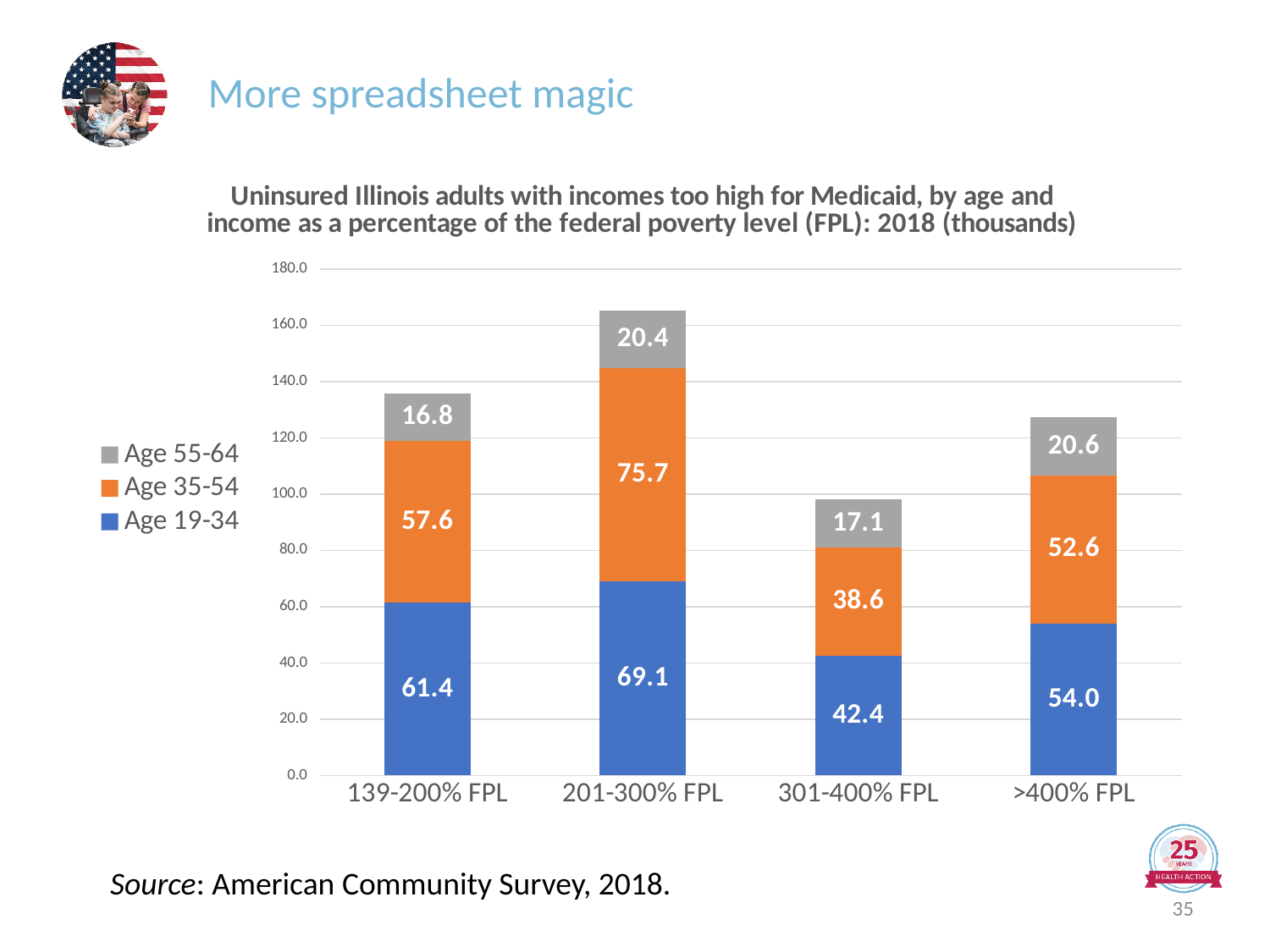
How many series does the legend list? 3 What is the difference between the Age 19-34 values for 139-200% FPL and 301-400% FPL? 19.0 What is the value for Age 19-34 in the 201-300% FPL category? 69.1 What kind of chart is shown on the slide? Stacked bar chart Which income category has the lowest value for Age 19-34? 301-400% FPL Which income category has the highest value for Age 35-54? 201-300% FPL Which is larger: the Age 55-64 value for 139-200% FPL or for >400% FPL? >400% FPL What is the total of the stacked bar for 301-400% FPL? 98.1 What is the value for Age 55-64 in the 301-400% FPL category? 17.1 What is the value for Age 35-54 in the >400% FPL category? 52.6 How many income categories are shown on the x axis? 4 What is the total of the stacked bar for 201-300% FPL? 165.2